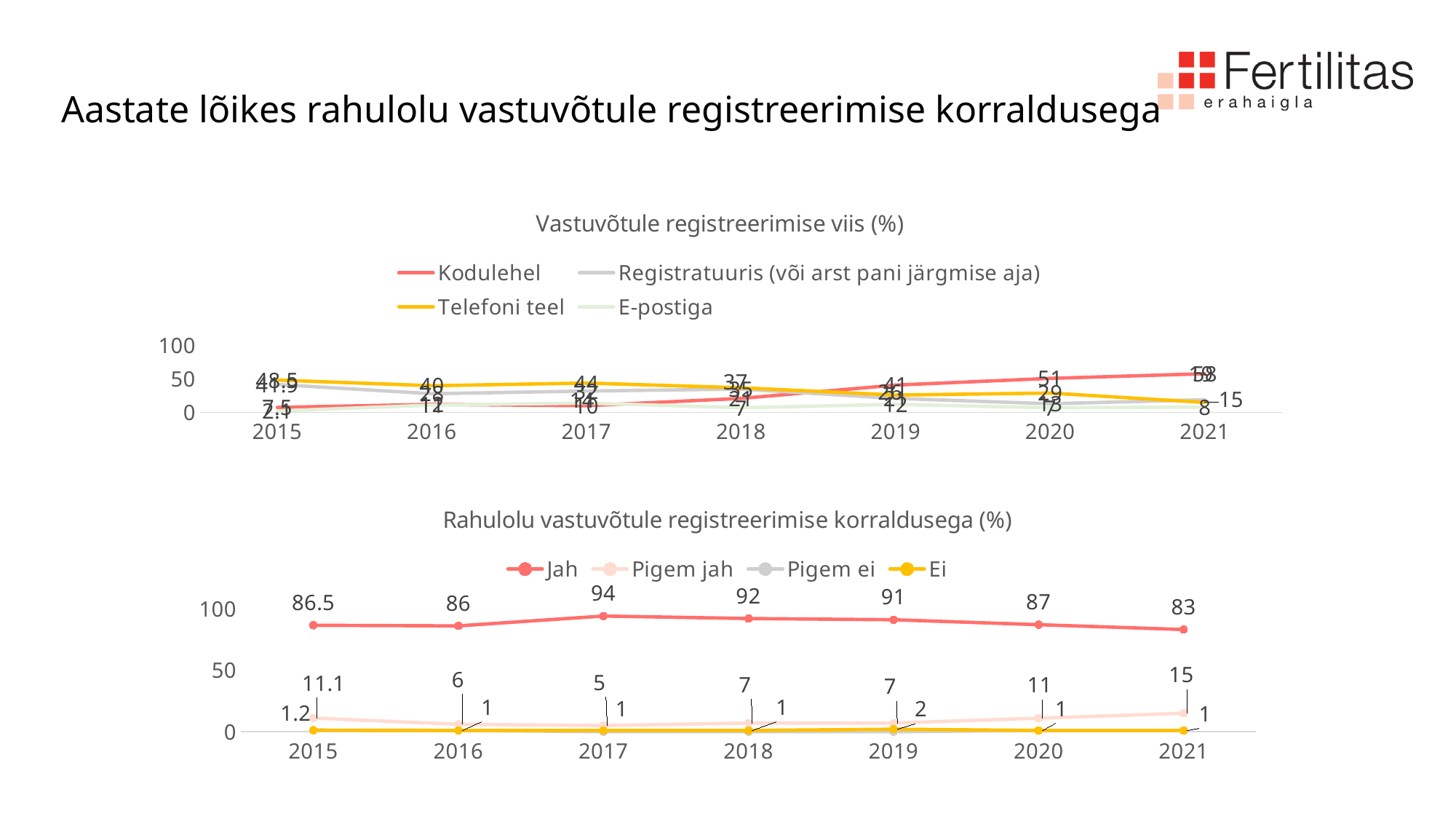
In the bottom chart (Rahulolu vastuvõtule registreerimise korraldusega), does the Jah value rise or fall from 2017 to 2021? fall In the bottom chart (Rahulolu vastuvõtule registreerimise korraldusega), how many years are shown on the x axis? 7 In the top chart (Vastuvõtule registreerimise viis), is the value for Kodulehel in 2015 greater or less than 50? less What kind of chart is the top chart (Vastuvõtule registreerimise viis)? line chart In the bottom chart (Rahulolu vastuvõtule registreerimise korraldusega), in which year is the Jah value lowest? 2021 In the bottom chart (Rahulolu vastuvõtule registreerimise korraldusega), in which year is the Jah value highest? 2017 In the bottom chart (Rahulolu vastuvõtule registreerimise korraldusega), what is the difference between the Jah value in 2017 and in 2021? 11 In the bottom chart (Rahulolu vastuvõtule registreerimise korraldusega), which is larger: Pigem jah in 2015 or Pigem jah in 2017? 2015 In the bottom chart (Rahulolu vastuvõtule registreerimise korraldusega), what is the value for Pigem jah in 2021? 15 In the bottom chart (Rahulolu vastuvõtule registreerimise korraldusega), what is the value for Jah in 2017? 94 In the top chart (Vastuvõtule registreerimise viis), what is the value for Kodulehel in 2020? 51 In the bottom chart (Rahulolu vastuvõtule registreerimise korraldusega), how many series does the legend list? 4